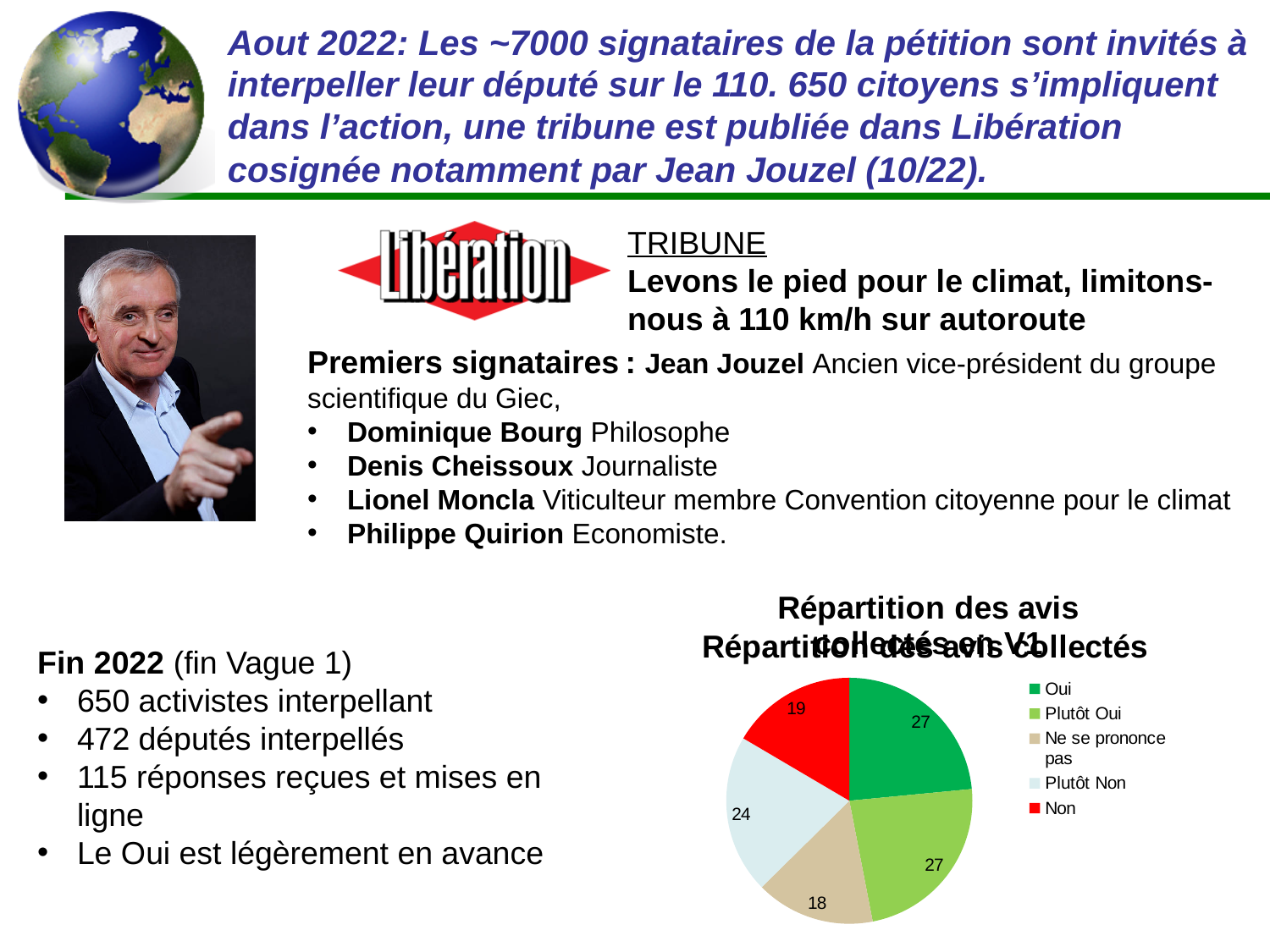
What value is shown for the "Plutôt Non" slice of the pie chart? 24 What value is shown for the "Ne se prononce pas" slice of the pie chart? 18 What type of chart is shown on the slide? Pie chart What value is shown for the "Non" slice of the pie chart? 19 What value is shown for the "Plutôt Oui" slice of the pie chart? 27 What is the difference between the "Plutôt Non" value and the "Non" value in the pie chart? 5 What is the difference between the "Oui" value and the "Ne se prononce pas" value in the pie chart? 9 Which category has the smallest slice in the pie chart? Ne se prononce pas How many slices does the pie chart have? 5 Which is larger in the pie chart, "Plutôt Non" or "Non"? Plutôt Non What value is shown for the "Oui" slice of the pie chart? 27 What colour is the "Non" slice in the pie chart? Red